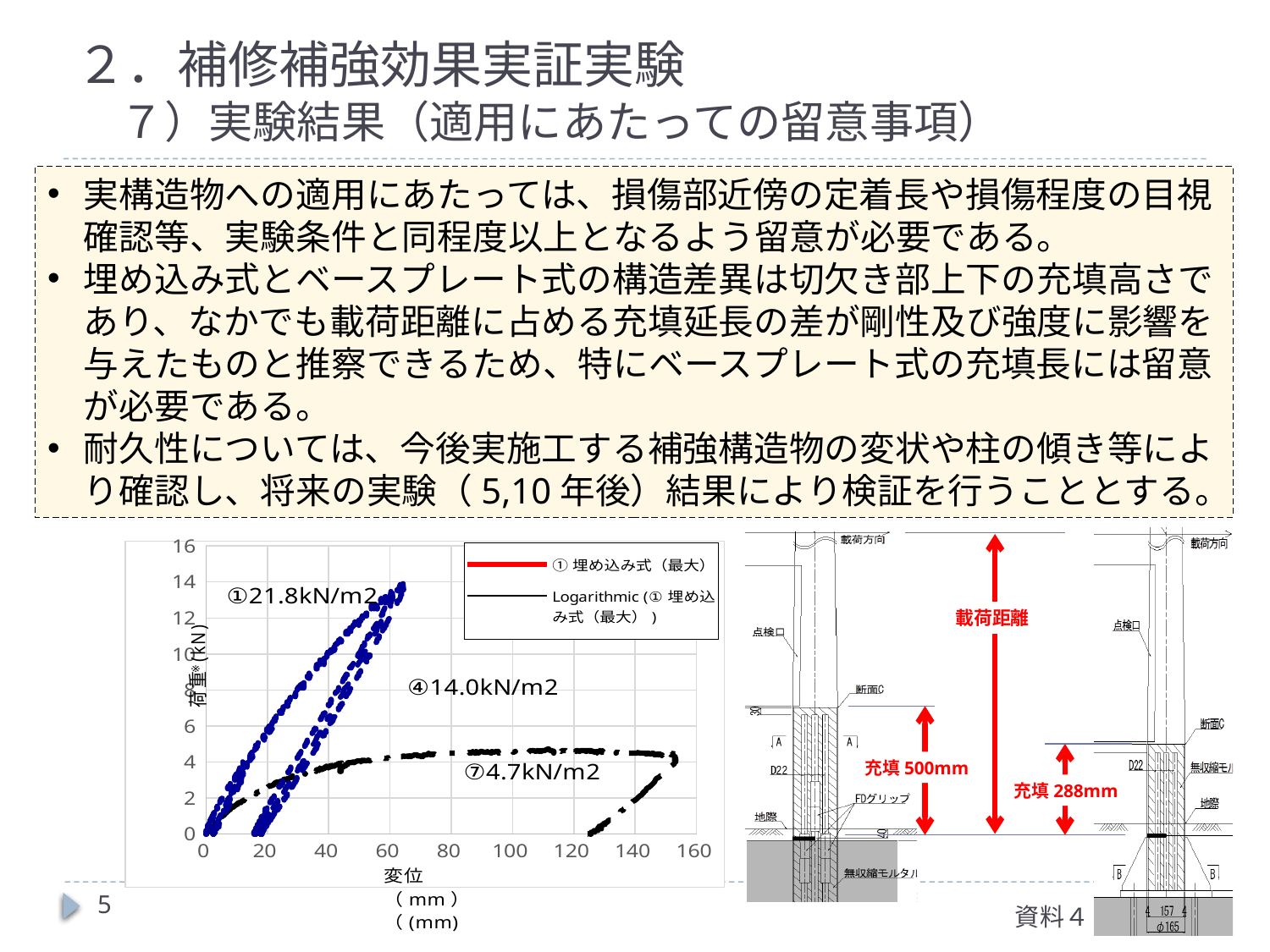
In the bottom-left chart, what value is printed in the annotation labelled ①? 21.8kN/m2 In the bottom-left chart, is the peak load reached by the black dashed series greater or less than 6 kN? less In the bottom-left chart, what value is printed in the annotation labelled ④? 14.0kN/m2 How many series does the legend of the bottom-left chart list? 2 In the bottom-left chart, which series reaches the higher peak load, the blue series or the black dashed series? the blue series In the bottom-left chart, is the peak load reached by the blue series greater or less than 12 kN? greater What is the highest tick value shown on the y axis of the bottom-left chart? 16 What is the label of the x axis of the bottom-left chart? 変位 (mm) What is the first entry in the legend of the bottom-left chart? ① 埋め込み式（最大） What kind of chart is shown at the bottom left of the slide? scatter chart In the bottom-left chart, what value is printed in the annotation labelled ⑦? 4.7kN/m2 In the bottom-left chart, is the largest displacement reached by the black dashed series greater or less than 140 mm? greater